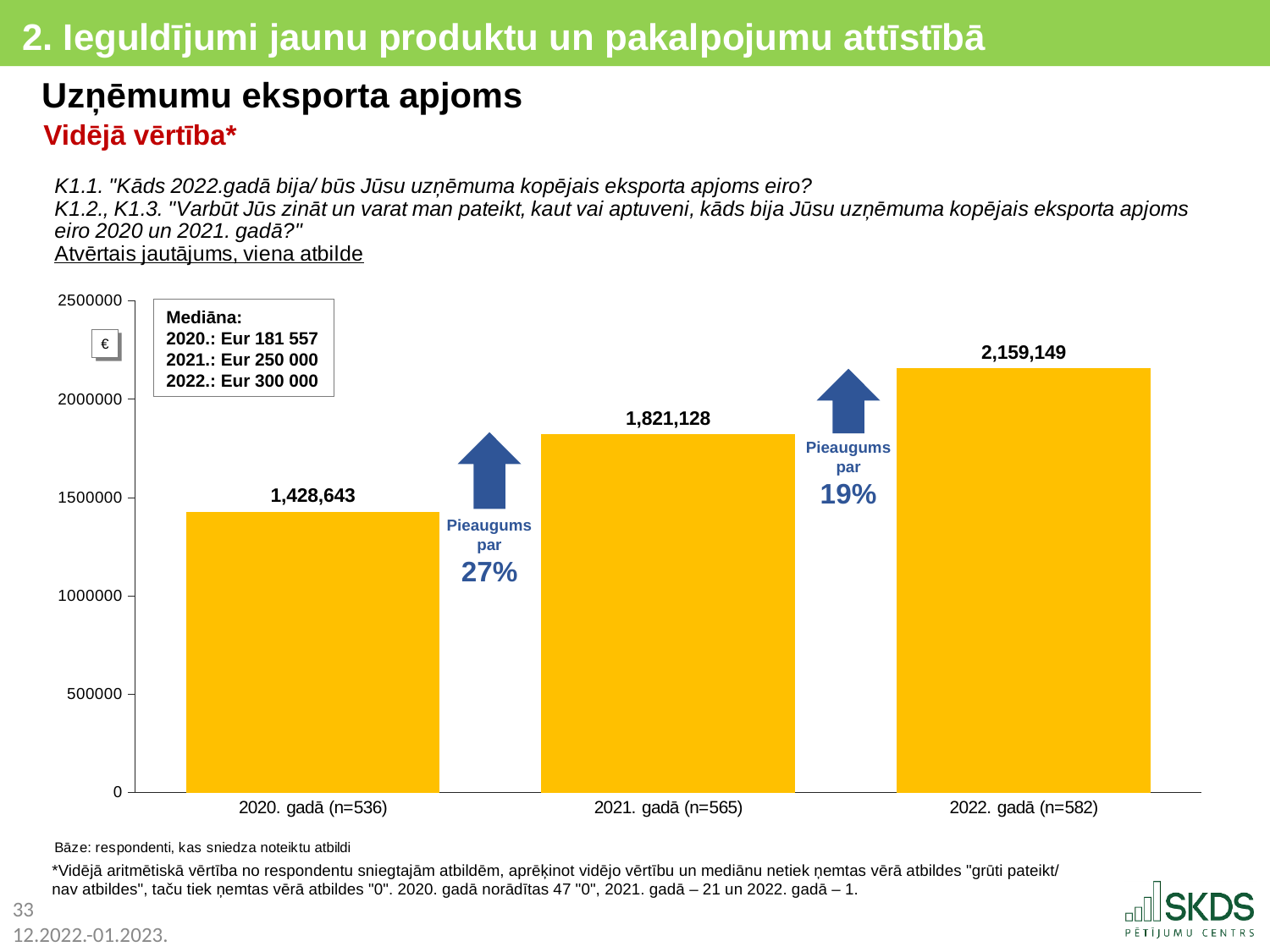
What is the difference between the 2022 and 2021 average export volumes? 338,021 What kind of chart is shown on the slide? bar chart What is the average export volume shown for 2021. gadā (n=565)? 1,821,128 Is the value for 2022. gadā (n=582) greater or less than 2000000? greater Which year has the highest average export volume? 2022. gadā (n=582) What is the average export volume shown for 2020. gadā (n=536)? 1,428,643 Which is larger, the average export volume for 2020 or for 2021? 2021 Which year has the lowest average export volume? 2020. gadā (n=536) What is the average export volume shown for 2022. gadā (n=582)? 2,159,149 How many years (bars) are shown in the chart? 3 What percentage increase is shown between 2020 and 2021? 27% What is the difference between the 2021 and 2020 average export volumes? 392,485